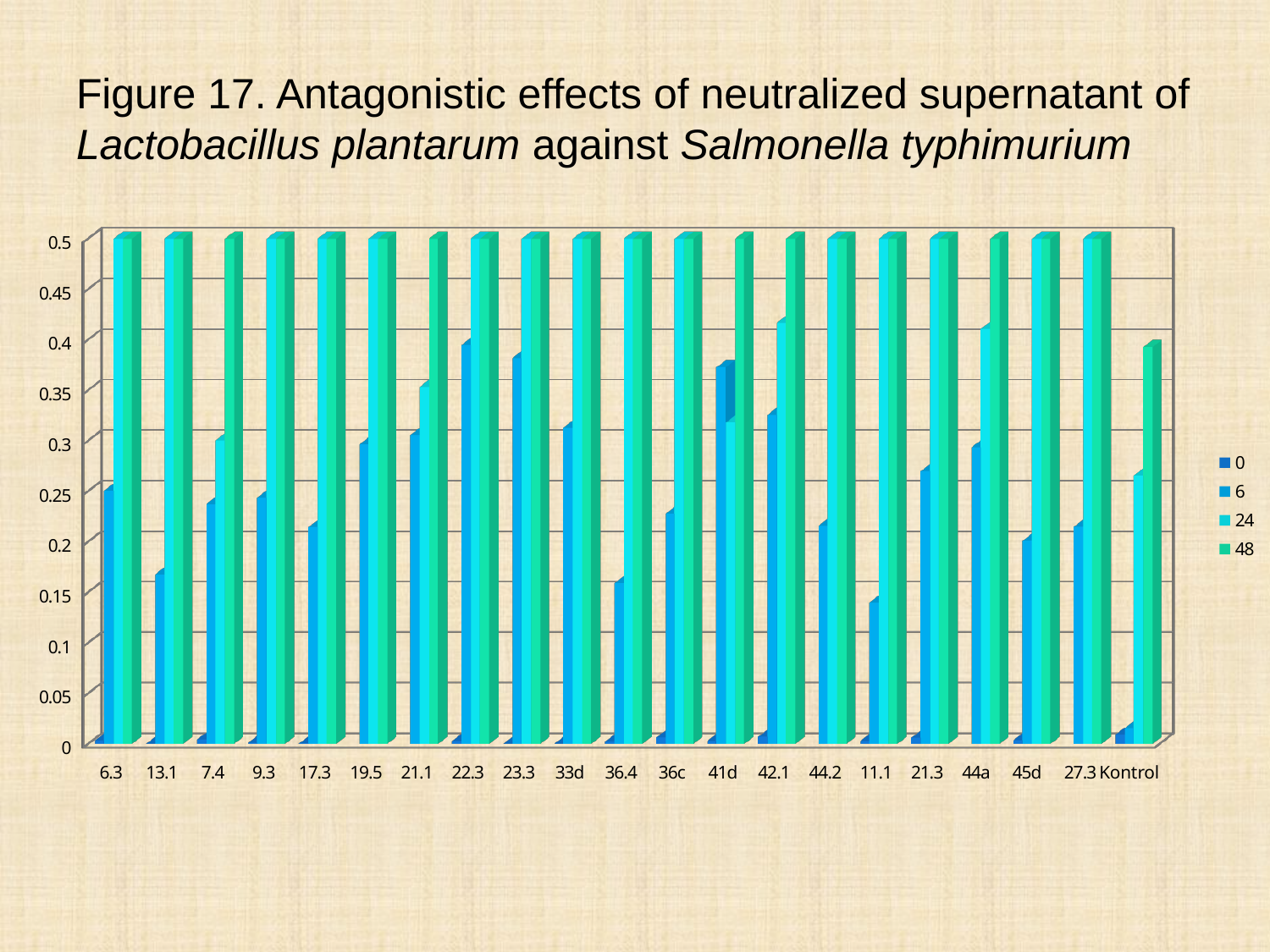
Is the value of series 6 for category 36.4 greater or less than 0.2? less What are the legend entries of the chart? 0, 6, 24, 48 For series 6, which is larger: the value for 13.1 or the value for 22.3? 22.3 What is the label of the last category on the x axis? Kontrol Is the value of series 48 for Kontrol greater or less than 0.5? less How many series does the legend list? 4 Is the value of series 6 for category 13.1 greater or less than 0.2? less What kind of chart is shown on the slide? bar chart How many categories are shown along the x axis? 21 For series 6, which is larger: the value for 36.4 or the value for 23.3? 23.3